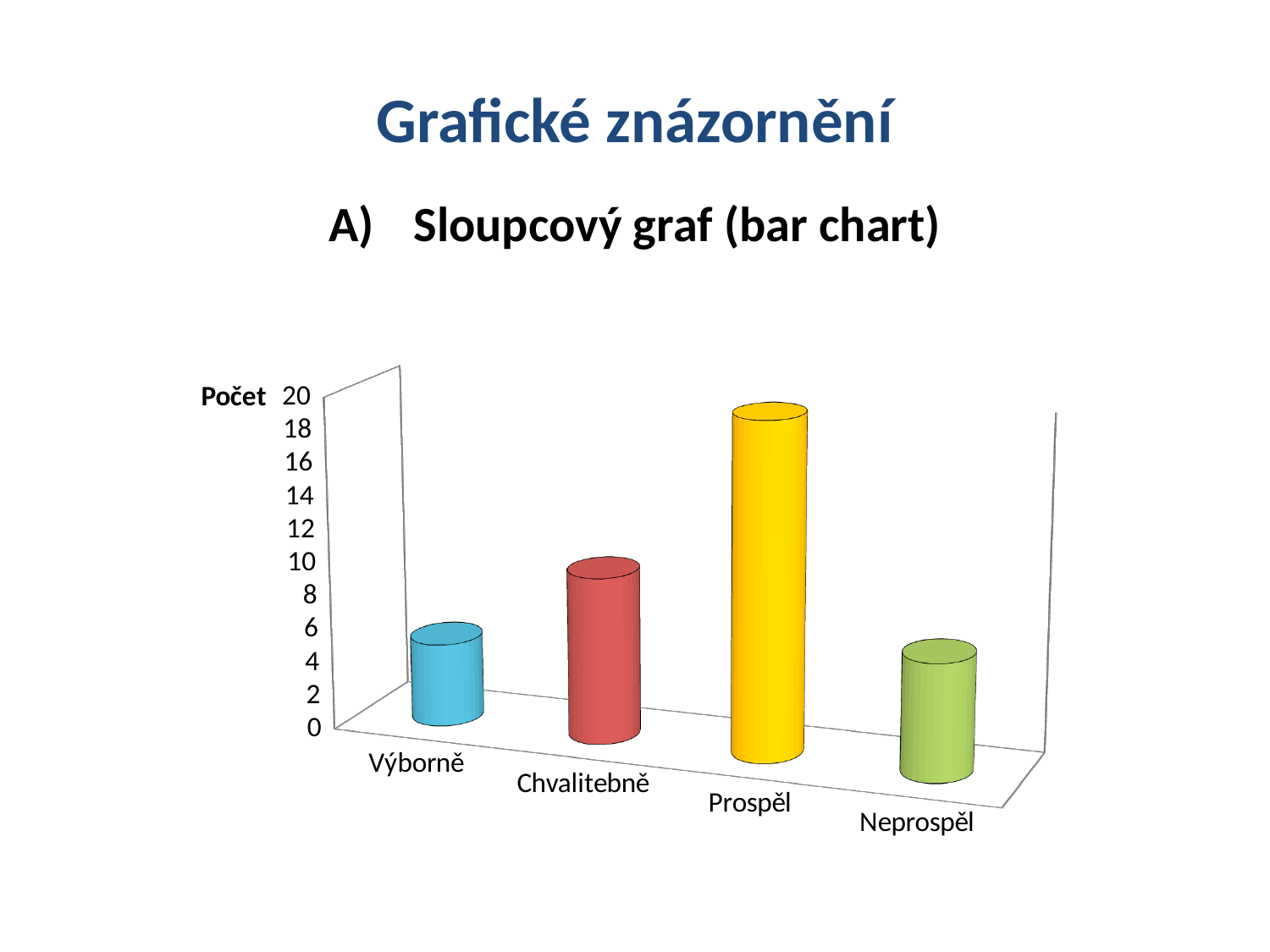
What kind of chart is shown on the slide? bar chart What is the label of the vertical axis of the chart? Počet How many categories are shown on the x axis of the chart? 4 Is the value for Výborně greater or less than 10? less Which is larger, the value for Chvalitebně or the value for Výborně? Chvalitebně Is the value for Neprospěl greater or less than 10? less Which category has the highest value in the chart? Prospěl Which is larger, the value for Prospěl or the value for Neprospěl? Prospěl What colour is the bar for Prospěl? yellow Is the value for Chvalitebně greater or less than 6? greater